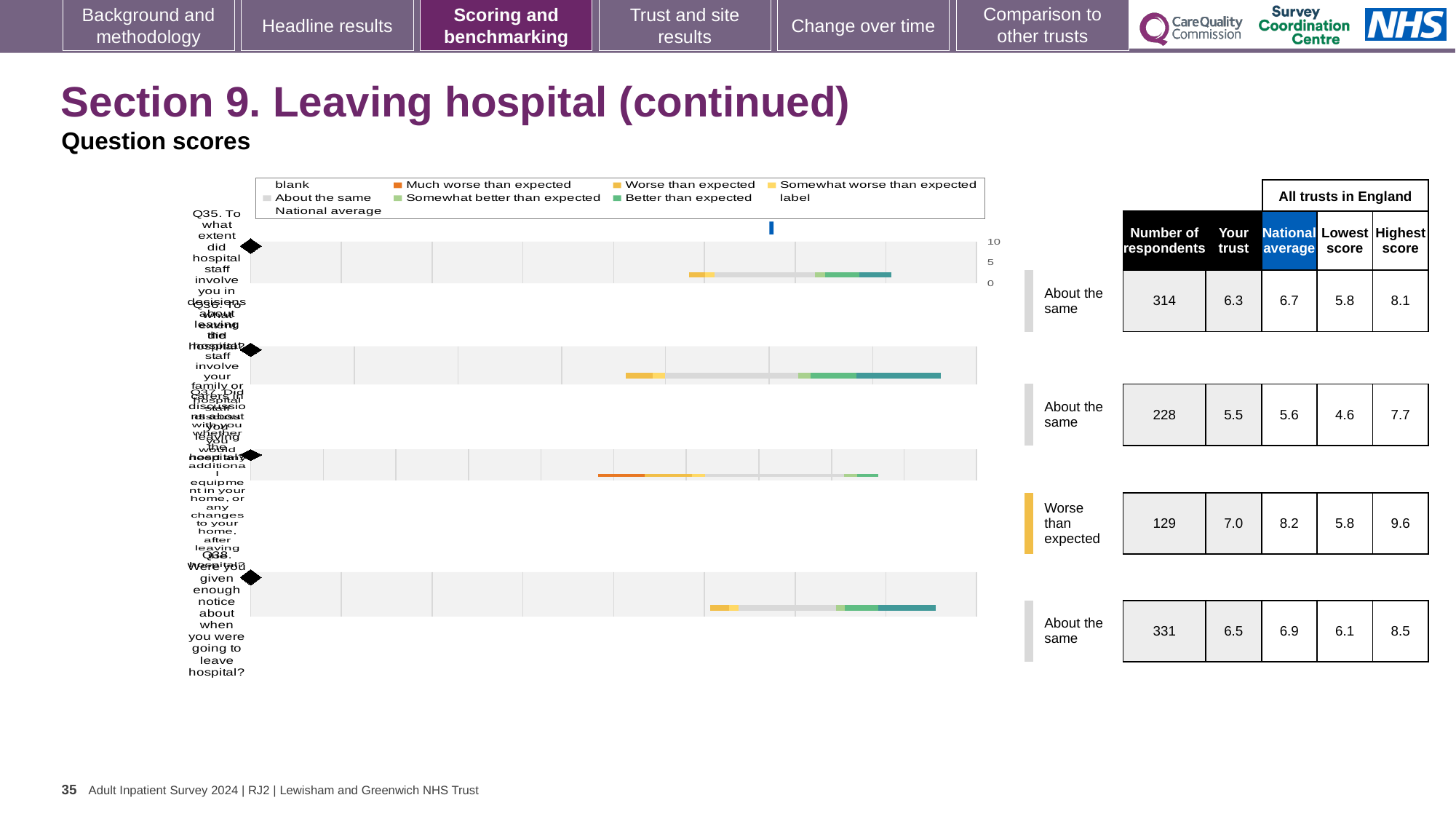
In the table beside the charts, what is the lowest score for the second question (Q36)? 4.6 In the table beside the charts, what is the highest score for the fourth question (Q38)? 8.5 In the table beside the charts, what is the 'Your trust' score for the first question (Q35)? 6.3 In the table beside the charts, what is the national average for the first question (Q35)? 6.7 In the table beside the charts, is the 'Your trust' score for the second question (Q36) higher or lower than its national average? lower In the table beside the charts, how many respondents are listed for the third question (Q37)? 129 In the table beside the charts, which question has the lowest 'Your trust' score? Q36 (5.5) In the table beside the charts, what is the difference between the national average and the 'Your trust' score for the third question (Q37)? 1.2 How many question score charts are shown on the slide? 4 Which question row in the table is rated 'Worse than expected'? Q37 (third row) What kind of chart is used to show the question scores on this slide? bar chart In the table beside the charts, which question has the most respondents? Q38 (331)